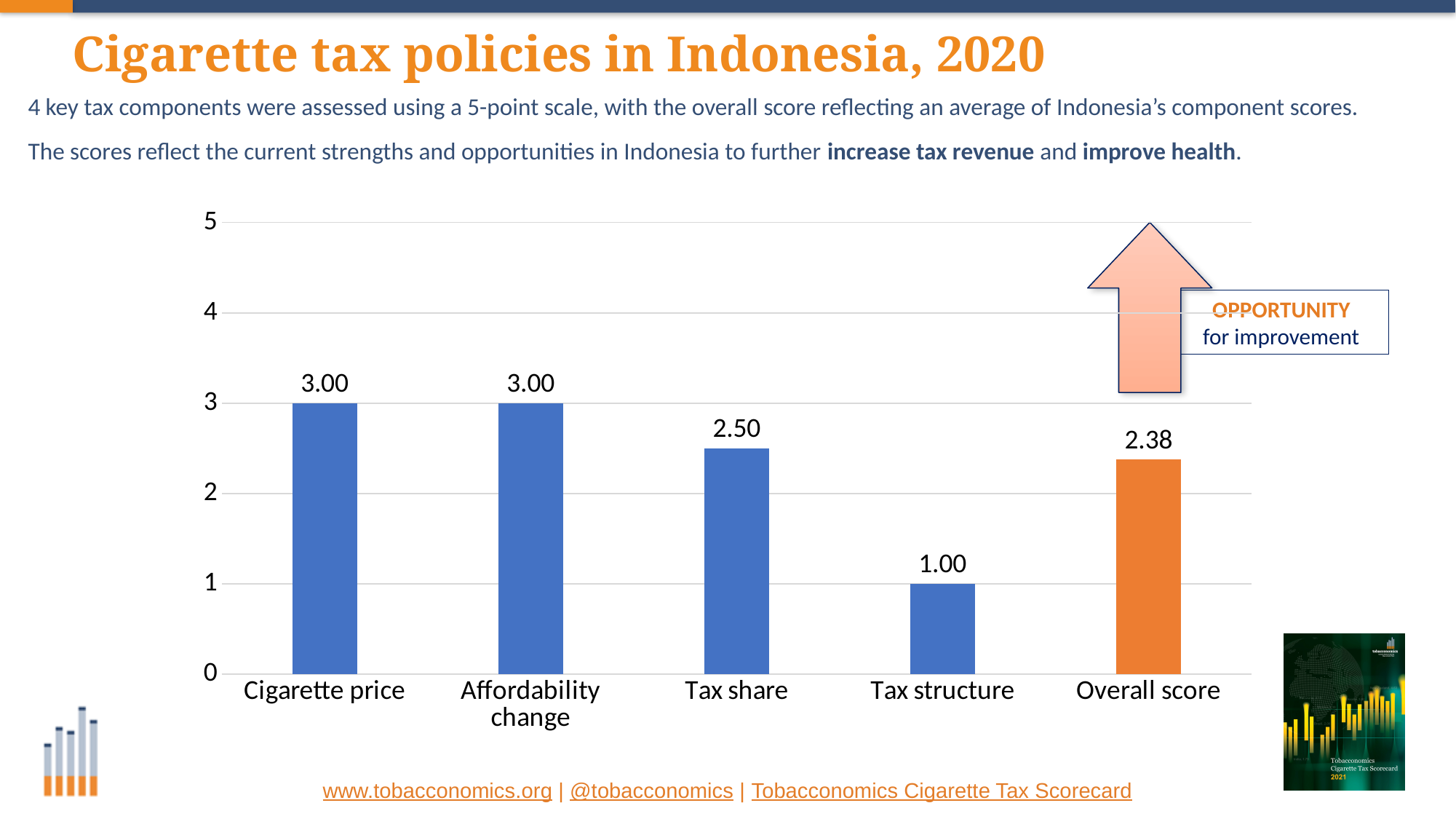
What type of chart is shown on the slide? bar chart What is the difference between the Tax share score and the Tax structure score? 1.50 Which bar is coloured orange rather than blue? Overall score What is the Overall score shown in the chart? 2.38 Is the Overall score greater or less than 3? less How many bars are shown in the chart? 5 Which component has the lowest score? Tax structure What is the score for Tax structure? 1.00 What is the maximum value shown on the vertical axis? 5 Which is larger, the score for Tax share or the score for Tax structure? Tax share What is the score for Tax share? 2.50 What is the difference between the Cigarette price score and the Overall score? 0.62